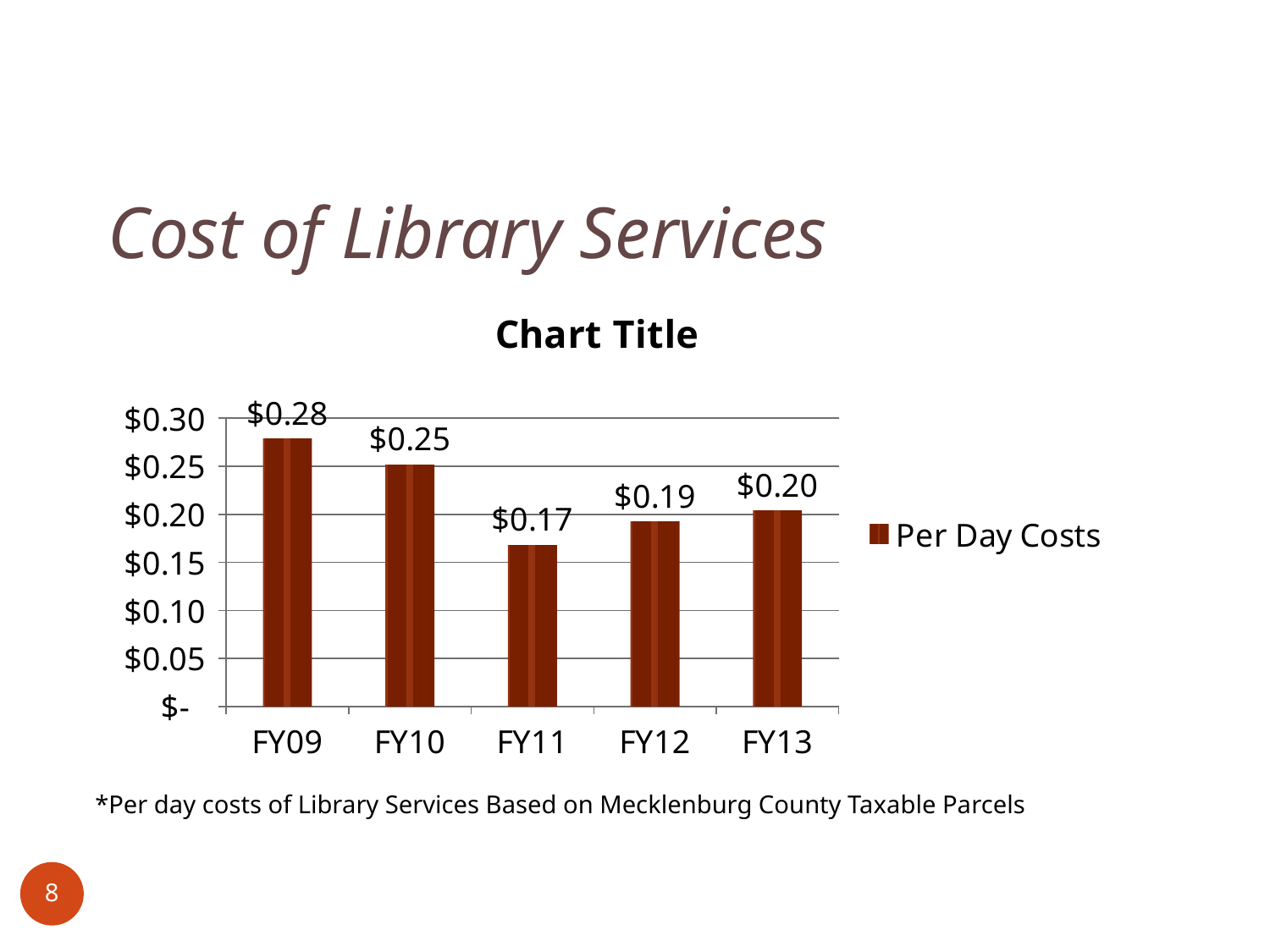
What is the difference between the Per Day Costs for FY09 and FY11? $0.11 How many fiscal years are shown on the x axis? 5 What kind of chart is shown on the slide? bar chart What is the Per Day Costs value for FY09? $0.28 What is the name of the series shown in the legend? Per Day Costs What is the Per Day Costs value for FY11? $0.17 Which fiscal year has the highest Per Day Costs value? FY09 Which fiscal year has the lowest Per Day Costs value? FY11 What is the Per Day Costs value for FY13? $0.20 Is the value for FY12 greater or less than $0.20? less Which is larger, the Per Day Costs for FY10 or FY12? FY10 How many series does the legend list? 1